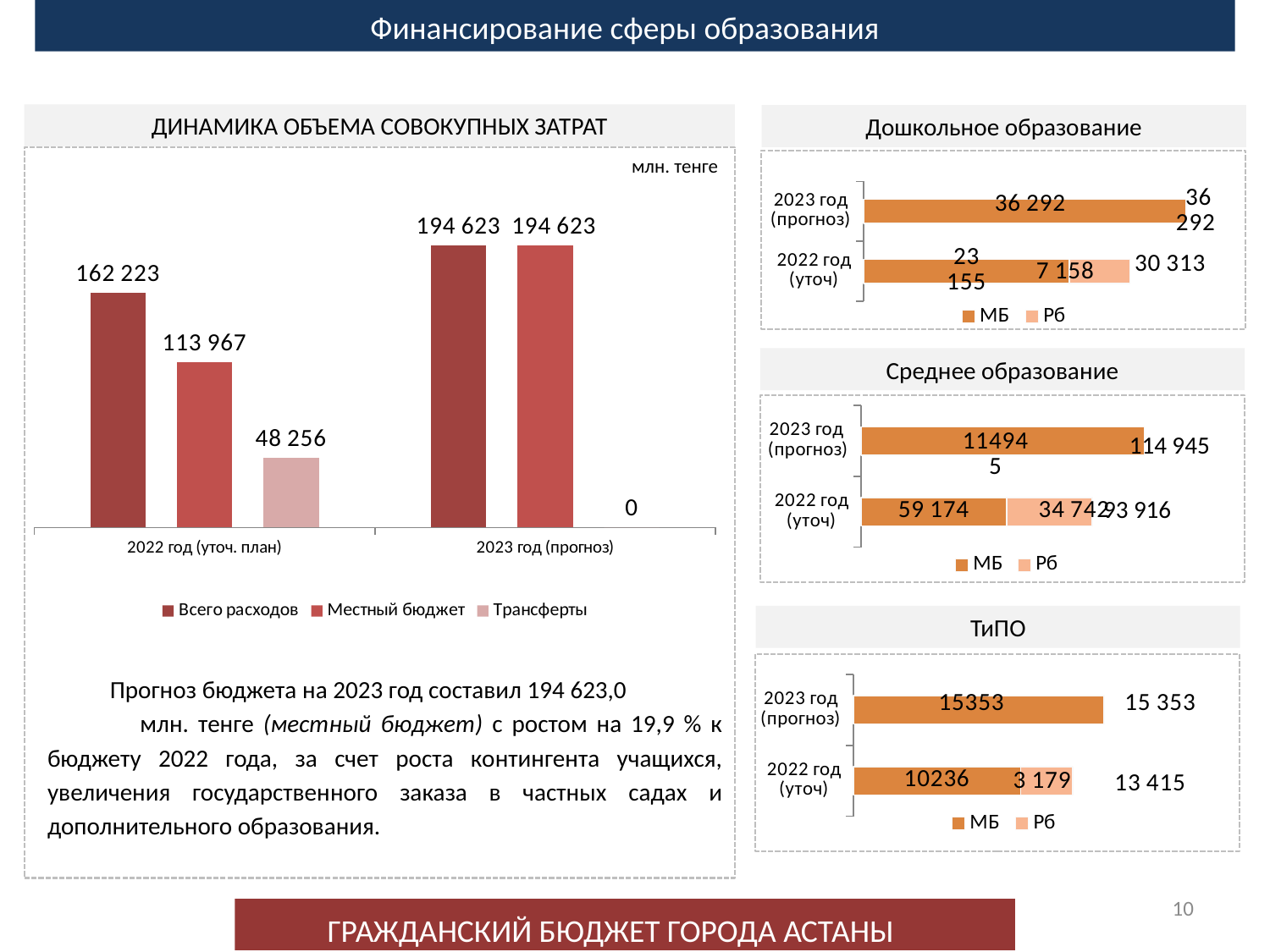
In the chart 'ТиПО', which year has the larger total, 2023 год (прогноз) or 2022 год (уточ)? 2023 год (прогноз) In the chart 'Среднее образование', what is the Рб value for '2022 год (уточ)'? 34 742 In the chart 'ДИНАМИКА ОБЪЕМА СОВОКУПНЫХ ЗАТРАТ', how many series does the legend list? 3 What kind of chart is the 'ТиПО' chart? Stacked horizontal bar chart In the chart 'Дошкольное образование', what is the total of the stacked bar for '2022 год (уточ)'? 30 313 In the chart 'Дошкольное образование', what is the МБ value for '2022 год (уточ)'? 23 155 In the chart 'ДИНАМИКА ОБЪЕМА СОВОКУПНЫХ ЗАТРАТ', what is the difference between 'Местный бюджет' in 2023 год (прогноз) and in 2022 год (уточ. план)? 80 656 In the chart 'ДИНАМИКА ОБЪЕМА СОВОКУПНЫХ ЗАТРАТ', what unit is shown in the top right corner? млн. тенге In the chart 'Дошкольное образование', what is the Рб value for '2022 год (уточ)'? 7 158 In the chart 'ДИНАМИКА ОБЪЕМА СОВОКУПНЫХ ЗАТРАТ', what is the value of 'Трансферты' for '2022 год (уточ. план)'? 48 256 In the chart 'ДИНАМИКА ОБЪЕМА СОВОКУПНЫХ ЗАТРАТ', what is the value of 'Трансферты' for '2023 год (прогноз)'? 0 In the chart 'ДИНАМИКА ОБЪЕМА СОВОКУПНЫХ ЗАТРАТ', what is the value of 'Всего расходов' for '2022 год (уточ. план)'? 162 223